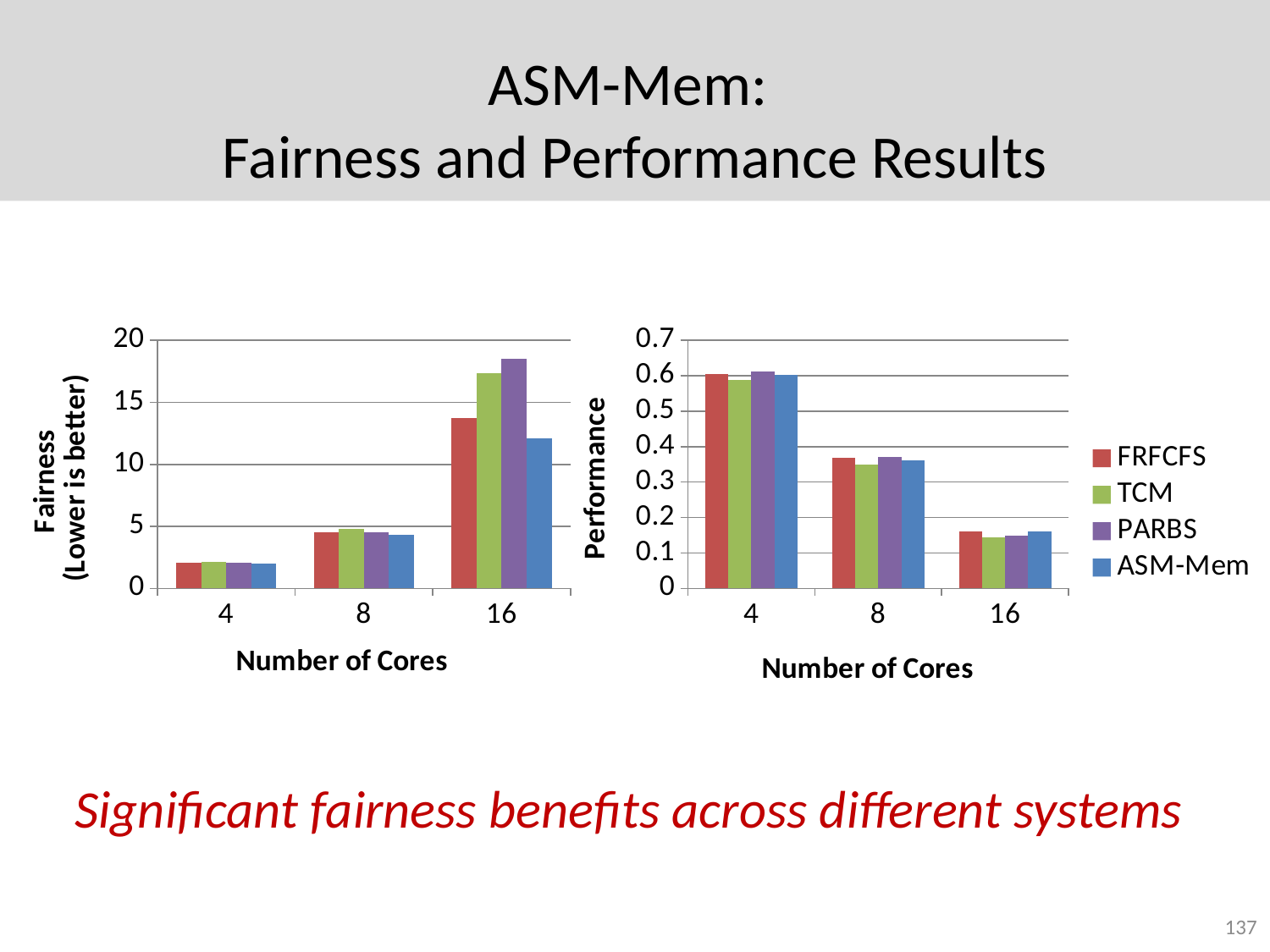
In the Fairness chart, which series has the highest value at 16 cores? PARBS In the Performance chart, is the value for TCM at 16 cores greater or less than 0.2? less What is the x-axis label of the Fairness chart? Number of Cores What kind of chart is the left chart (Fairness)? bar chart In the Fairness chart, is the value for ASM-Mem at 16 cores greater or less than 15? less In the Fairness chart, which series has the lowest value at 16 cores? ASM-Mem How many series does the legend list for the charts? 4 In the Fairness chart, is the value for PARBS at 16 cores greater or less than 15? greater How many core-count categories are shown on the x axis of the Performance chart? 3 In the Performance chart, do the values rise or fall as the number of cores increases? fall